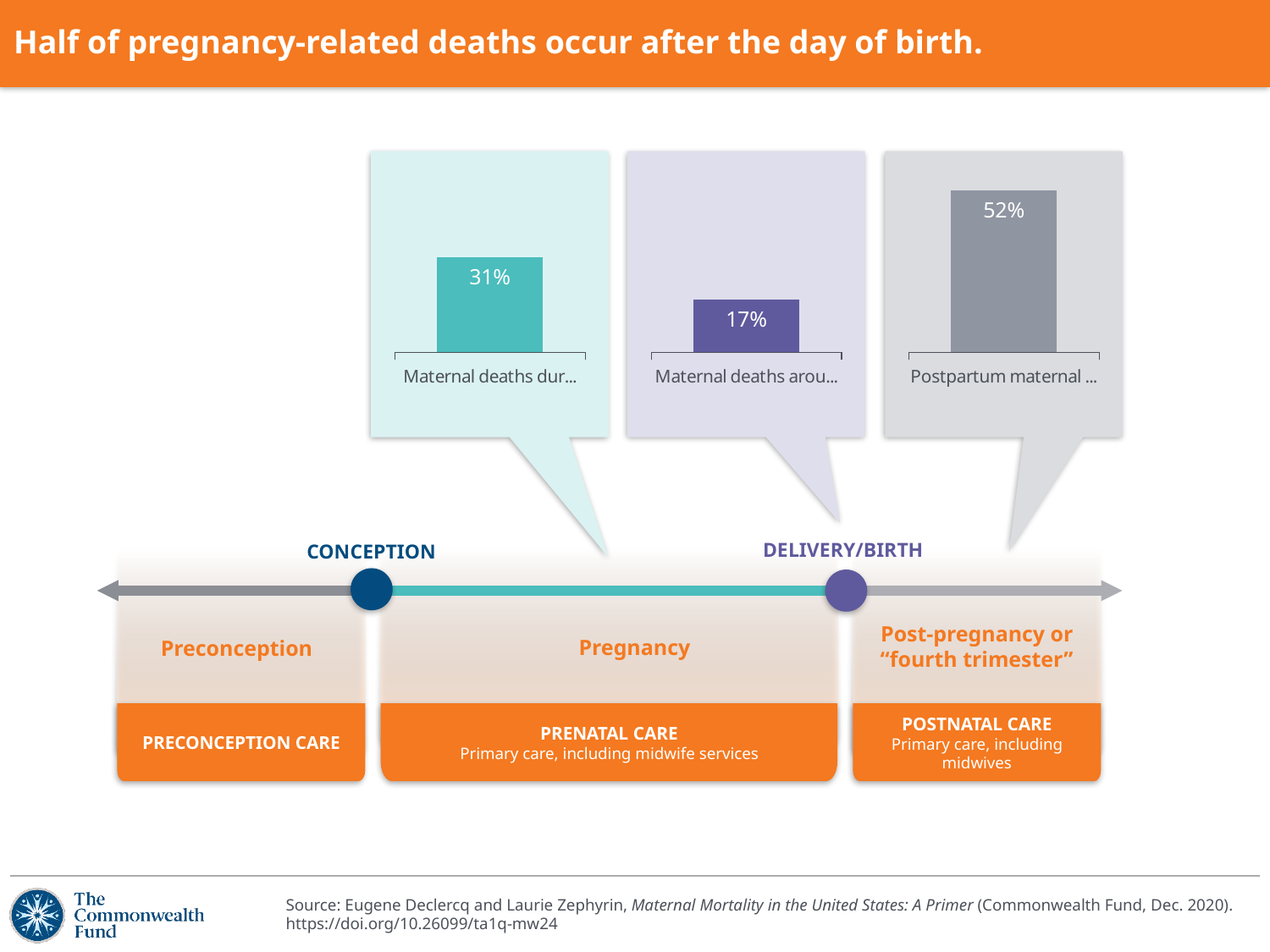
What value is shown on the bar in the right chart (above the Post-pregnancy section)? 52% Which of the three charts shows the highest percentage? The right chart (52%) What kind of chart is used in each of the three callout boxes? Bar chart How many bars are plotted in each of the three charts? 1 What value is shown on the bar in the left chart (above the Pregnancy section)? 31% Which of the three charts shows the lowest percentage? The middle chart (17%) Is the value in the left chart larger or smaller than the value in the middle chart? Larger What is the difference between the value in the left chart and the value in the middle chart? 14 percentage points What value is shown on the bar in the middle chart (above Delivery/Birth)? 17% What is the difference between the value in the right chart and the value in the left chart? 21 percentage points What is the total of the three percentages shown across the three charts? 100% What colour is the bar in the middle chart? Purple